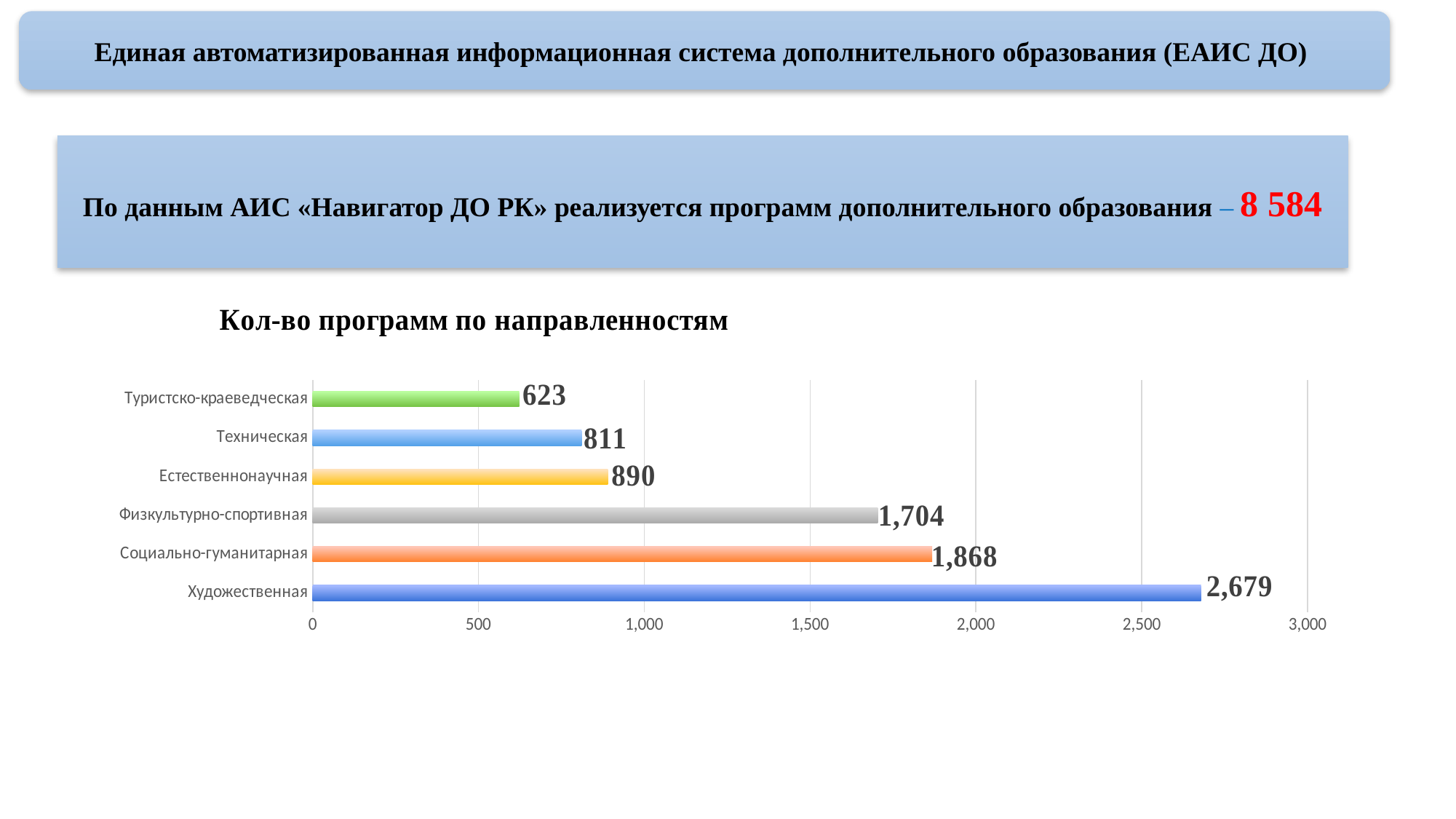
What kind of chart is shown on the slide? bar chart Which is larger, the value for Естественнонаучная or the value for Техническая? Естественнонаучная What is the value for Техническая? 811 Which category has the lowest value? Туристско-краеведческая What is the difference between the values for Социально-гуманитарная and Физкультурно-спортивная? 164 What is the value for Физкультурно-спортивная? 1,704 What is the title of the chart? Кол-во программ по направленностям Is the value for Социально-гуманитарная greater or less than 1,500? greater Which category has the highest value? Художественная How many categories are shown in the chart? 6 What is the value for Художественная? 2,679 What is the difference between the values for Художественная and Туристско-краеведческая? 2,056